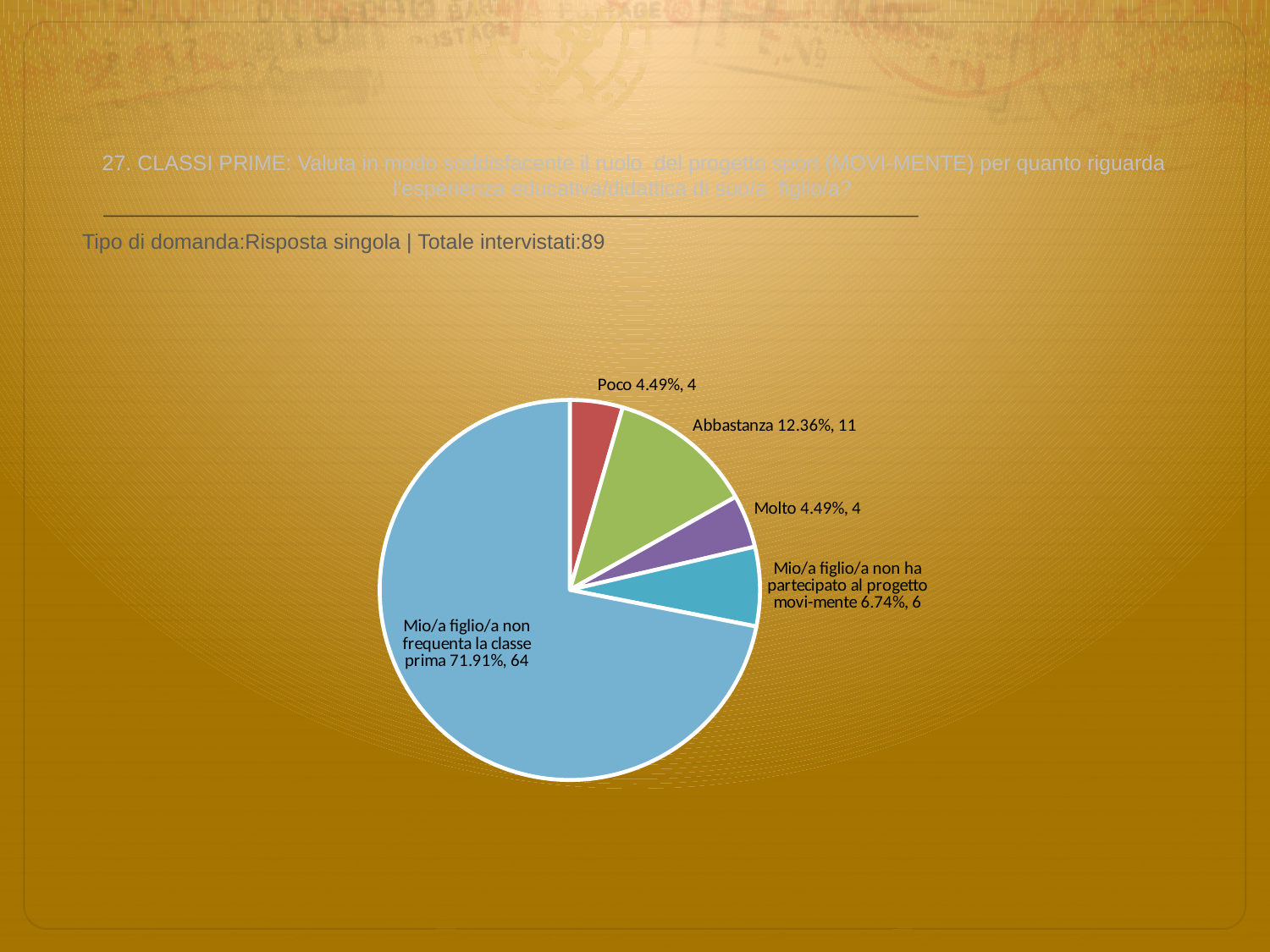
What percentage is shown for "Poco"? 4.49% What percentage of the pie does the slice "Mio/a figlio/a non frequenta la classe prima" represent? 71.91% What is the difference between the number of respondents for "Mio/a figlio/a non frequenta la classe prima" and for "Poco"? 60 What colour is the largest slice of the pie chart? light blue How many respondents answered "Abbastanza"? 11 Which is larger, the count for "Abbastanza" or the count for "Molto"? Abbastanza How many slices does the pie chart have? 5 Which category has the largest slice of the pie? Mio/a figlio/a non frequenta la classe prima What is the difference in respondents between "Abbastanza" and "Mio/a figlio/a non ha partecipato al progetto movi-mente"? 5 What kind of chart is shown on the slide? pie chart How many respondents are in the slice "Mio/a figlio/a non ha partecipato al progetto movi-mente"? 6 What percentage is shown for "Molto"? 4.49%